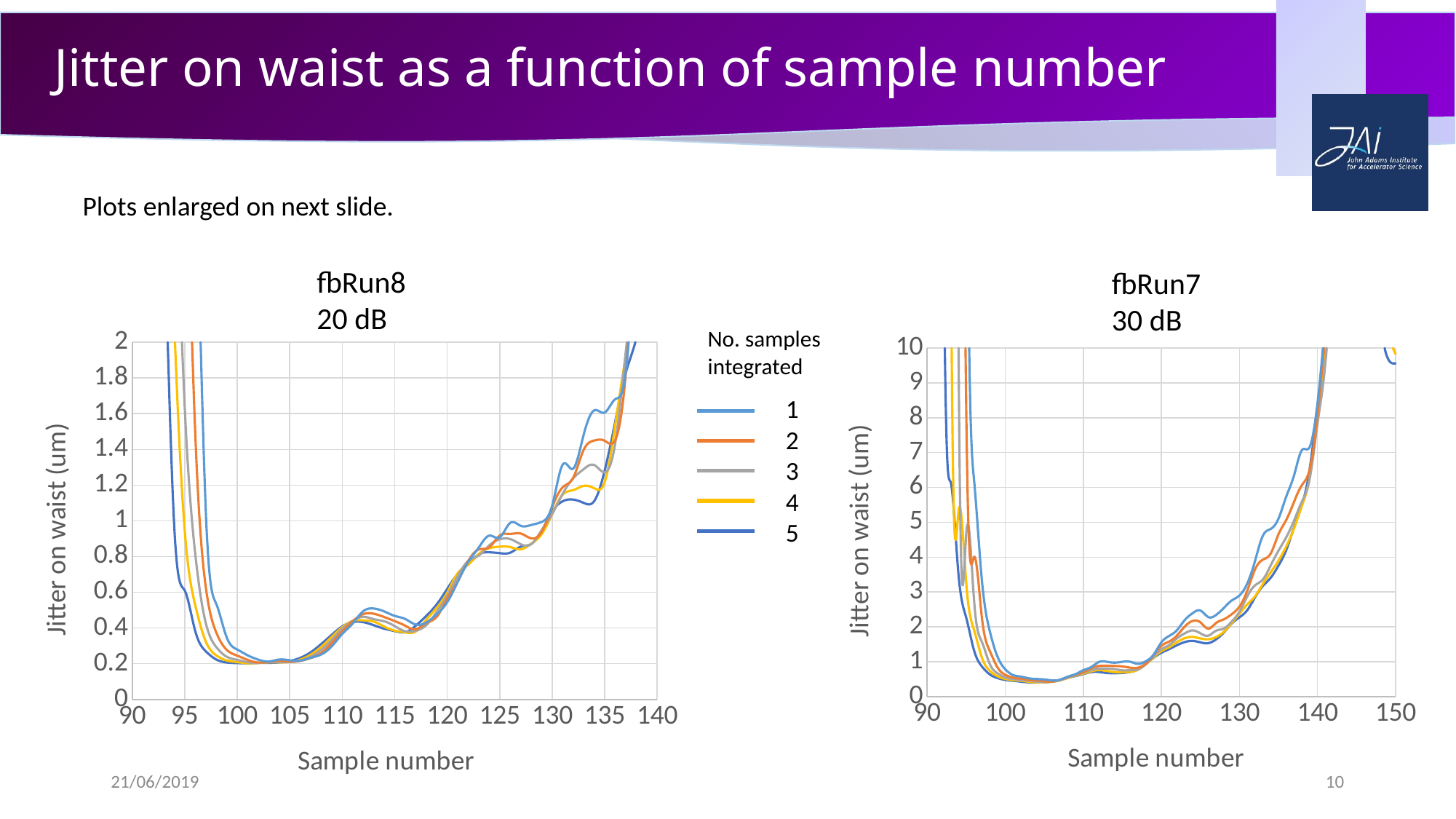
In the fbRun7 30 dB chart, at sample number 125, which series has the larger value: series 1 or series 5? Series 1 What kind of chart is the fbRun8 20 dB chart on the left? Line chart In the fbRun7 30 dB chart, is the value of series 1 at sample number 125 greater or less than 2? greater What is the y-axis label on the fbRun8 20 dB chart? Jitter on waist (um) In the fbRun7 30 dB chart, do the values rise or fall as the sample number increases from 92 to 100? Fall What is the title of the chart on the right? fbRun7 30 dB In the fbRun8 20 dB chart, do the values rise or fall as the sample number increases from 105 to 135? Rise How many series does the legend list for the charts? 5 In the fbRun8 20 dB chart, at sample number 133, which series has the larger value: series 1 or series 5? Series 1 In the fbRun8 20 dB chart, is the value of series 1 at sample number 105 greater or less than 0.4? less In the fbRun7 30 dB chart, is the value of series 5 at sample number 105 greater or less than 1? less